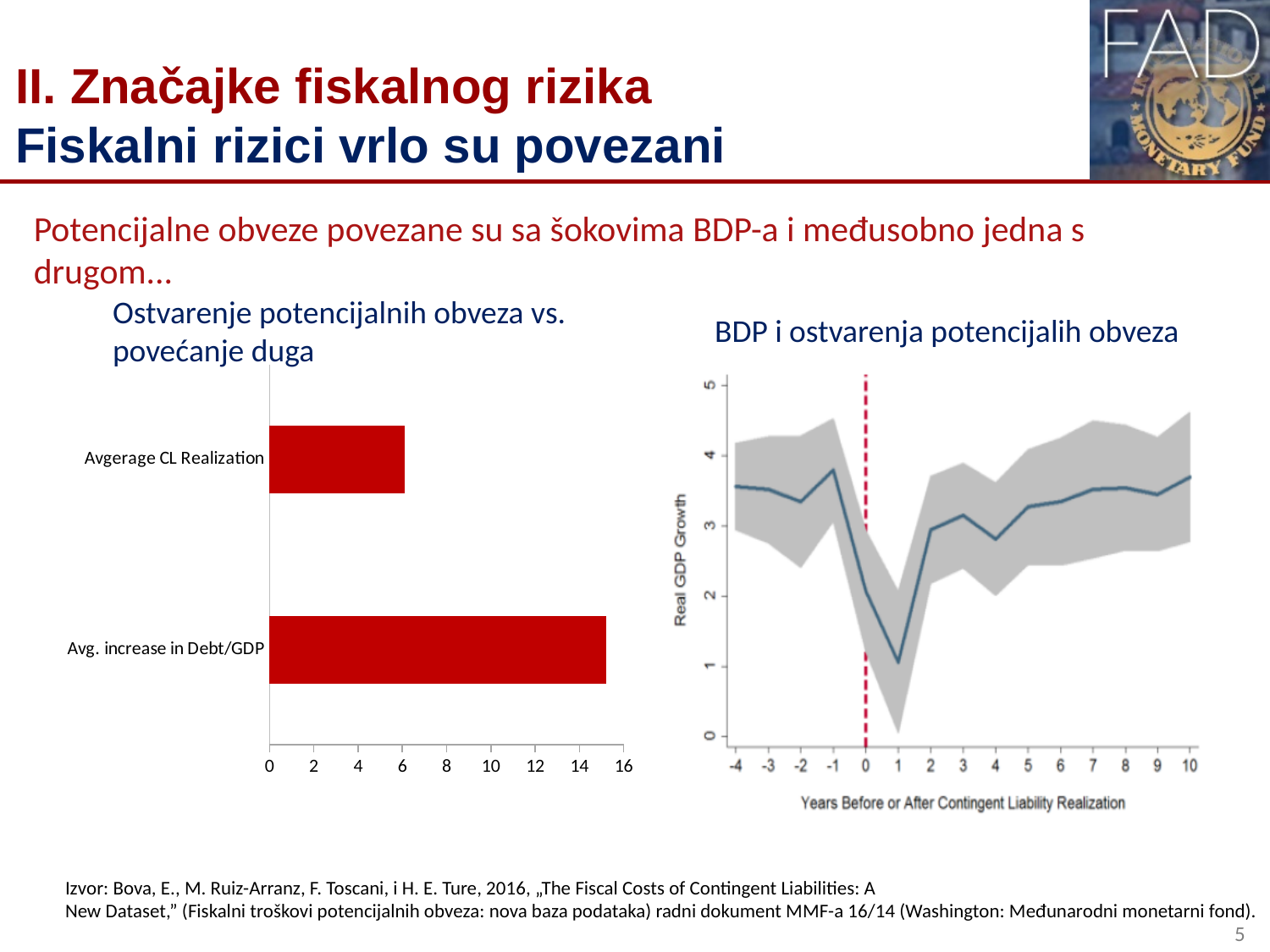
In the left bar chart, what is the maximum value shown on the horizontal axis? 16 In the right chart 'BDP i ostvarenja potencijalih obveza', does Real GDP Growth rise or fall between year -1 and year 1? fall In the left bar chart, which category has the lower value? Avgerage CL Realization In the right chart 'BDP i ostvarenja potencijalih obveza', what is the label of the x axis? Years Before or After Contingent Liability Realization What kind of chart is the left chart titled 'Ostvarenje potencijalnih obveza vs. povećanje duga'? bar chart In the left bar chart, how many categories are shown? 2 In the left bar chart, is the value for Avg. increase in Debt/GDP greater or less than 14? greater What kind of chart is the right chart titled 'BDP i ostvarenja potencijalih obveza'? line chart In the left bar chart, is the value for Avgerage CL Realization greater or less than 8? less In the left bar chart, which category has the higher value? Avg. increase in Debt/GDP In the right chart 'BDP i ostvarenja potencijalih obveza', at which year on the x axis does Real GDP Growth reach its lowest point? 1 In the right chart 'BDP i ostvarenja potencijalih obveza', is Real GDP Growth at year 1 greater or less than 2? less